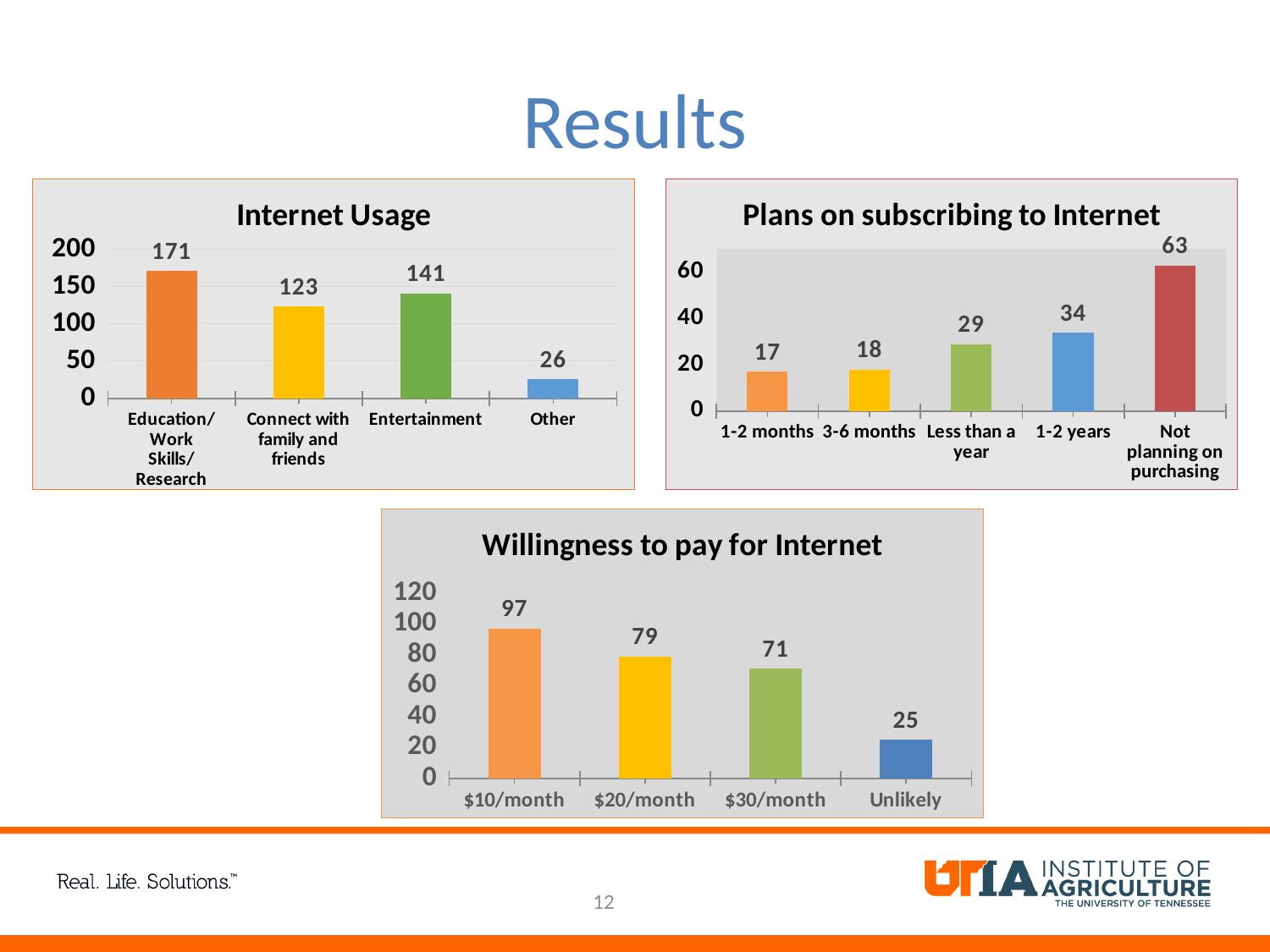
In the 'Internet Usage' chart, which category has the highest value? Education/Work Skills/Research In the 'Internet Usage' chart, what is the difference between Education/Work Skills/Research and Other? 145 In the 'Plans on subscribing to Internet' chart, which is larger: Less than a year or 3-6 months? Less than a year In the 'Willingness to pay for Internet' chart, what is the difference between $10/month and Unlikely? 72 In the 'Plans on subscribing to Internet' chart, which category has the lowest value? 1-2 months In the 'Plans on subscribing to Internet' chart, how many categories are shown? 5 In the 'Willingness to pay for Internet' chart, do the values rise or fall from $10/month to Unlikely? fall In the 'Internet Usage' chart, what is the value for Entertainment? 141 In the 'Internet Usage' chart, how many categories are shown? 4 In the 'Plans on subscribing to Internet' chart, what is the value for 1-2 years? 34 In the 'Willingness to pay for Internet' chart, what is the value for $20/month? 79 What kind of chart is the 'Willingness to pay for Internet' chart? bar chart